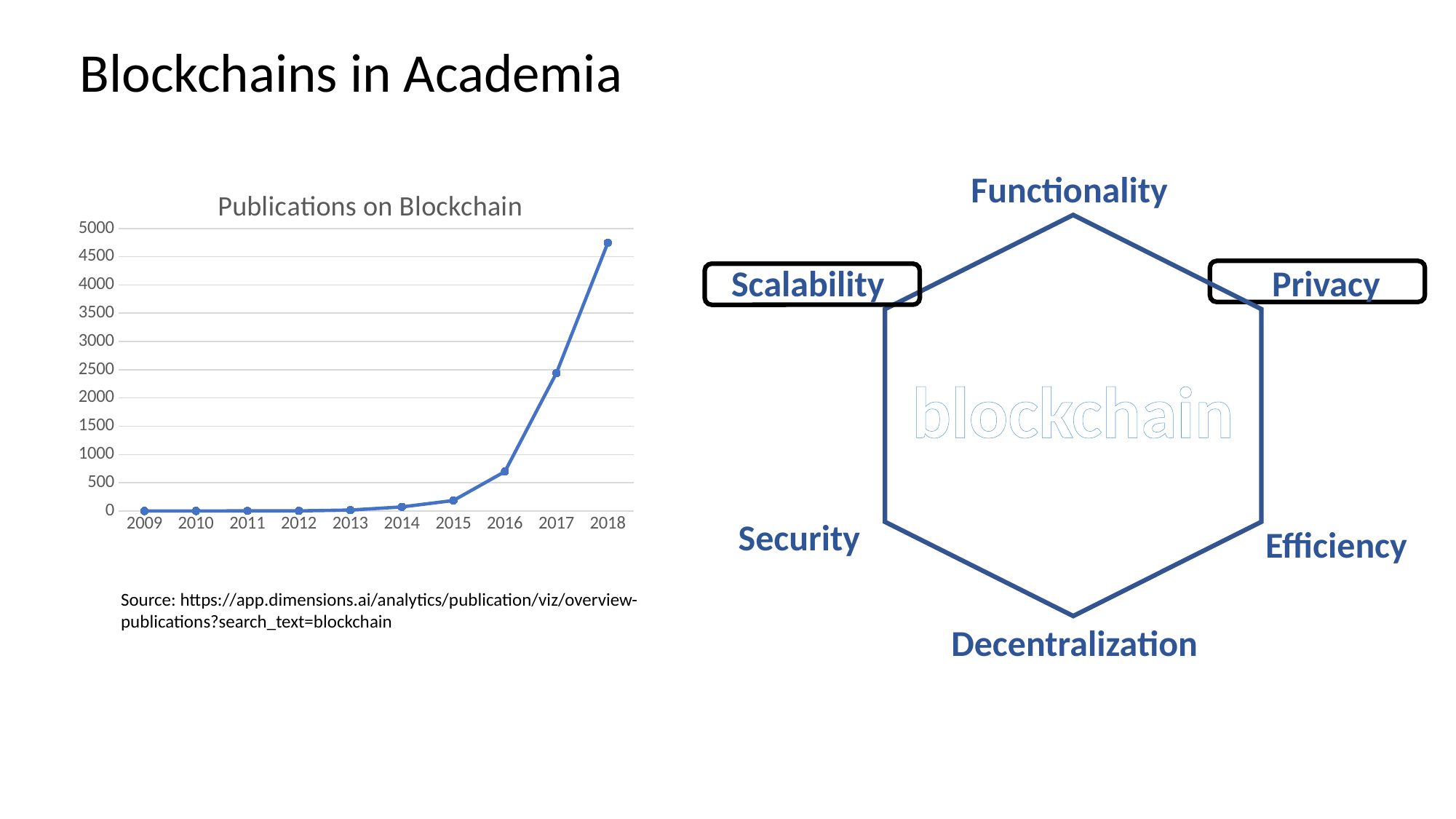
Is the value for 2015 greater or less than 500? less Which year has the highest number of publications on blockchain? 2018 What kind of chart is shown on the slide? line chart Which year has more publications, 2016 or 2017? 2017 Is the value for 2018 greater or less than 4500? greater How many years are plotted on the x axis of the chart? 10 What is the title of the chart? Publications on Blockchain Do the values in the chart rise or fall from 2009 to 2018? rise Is the value for 2017 greater or less than 3000? less What is the first year shown on the x axis of the chart? 2009